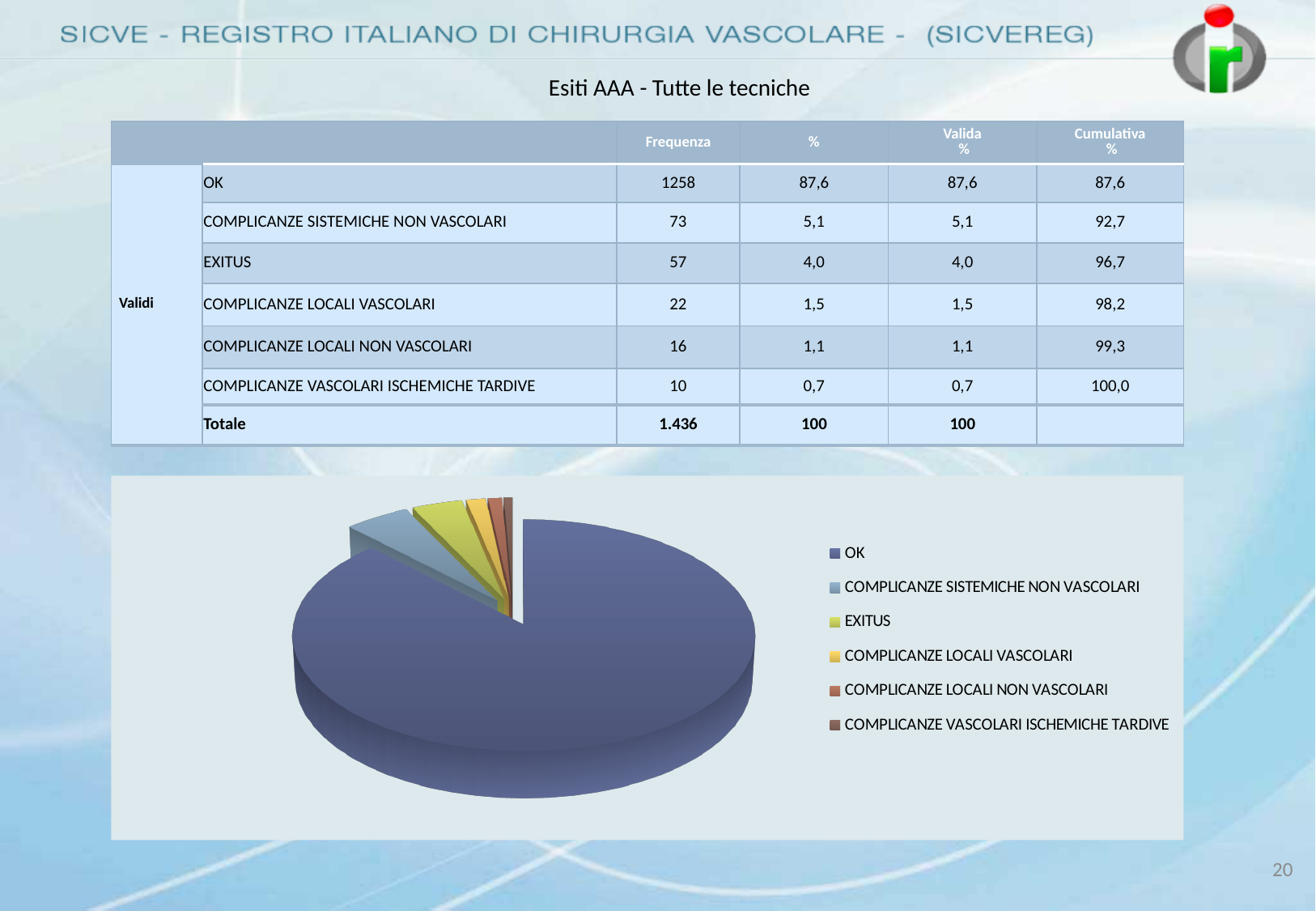
What share of the pie does the OK slice represent, according to the table? 87,6 What colour is the OK slice in the pie chart? blue What is the frequency for COMPLICANZE SISTEMICHE NON VASCOLARI shown in the table? 73 What is the frequency for EXITUS shown in the table? 57 How many slices does the pie chart have? 6 Which category has the largest slice in the pie chart? OK What is the difference in frequency between COMPLICANZE SISTEMICHE NON VASCOLARI and EXITUS? 16 Which is larger in the pie chart: the slice for EXITUS or the slice for COMPLICANZE LOCALI VASCOLARI? EXITUS Which category has the smallest slice in the pie chart? COMPLICANZE VASCOLARI ISCHEMICHE TARDIVE What is the total frequency shown in the table (Totale)? 1.436 How many entries does the pie chart's legend list? 6 What kind of chart is shown on the slide? pie chart